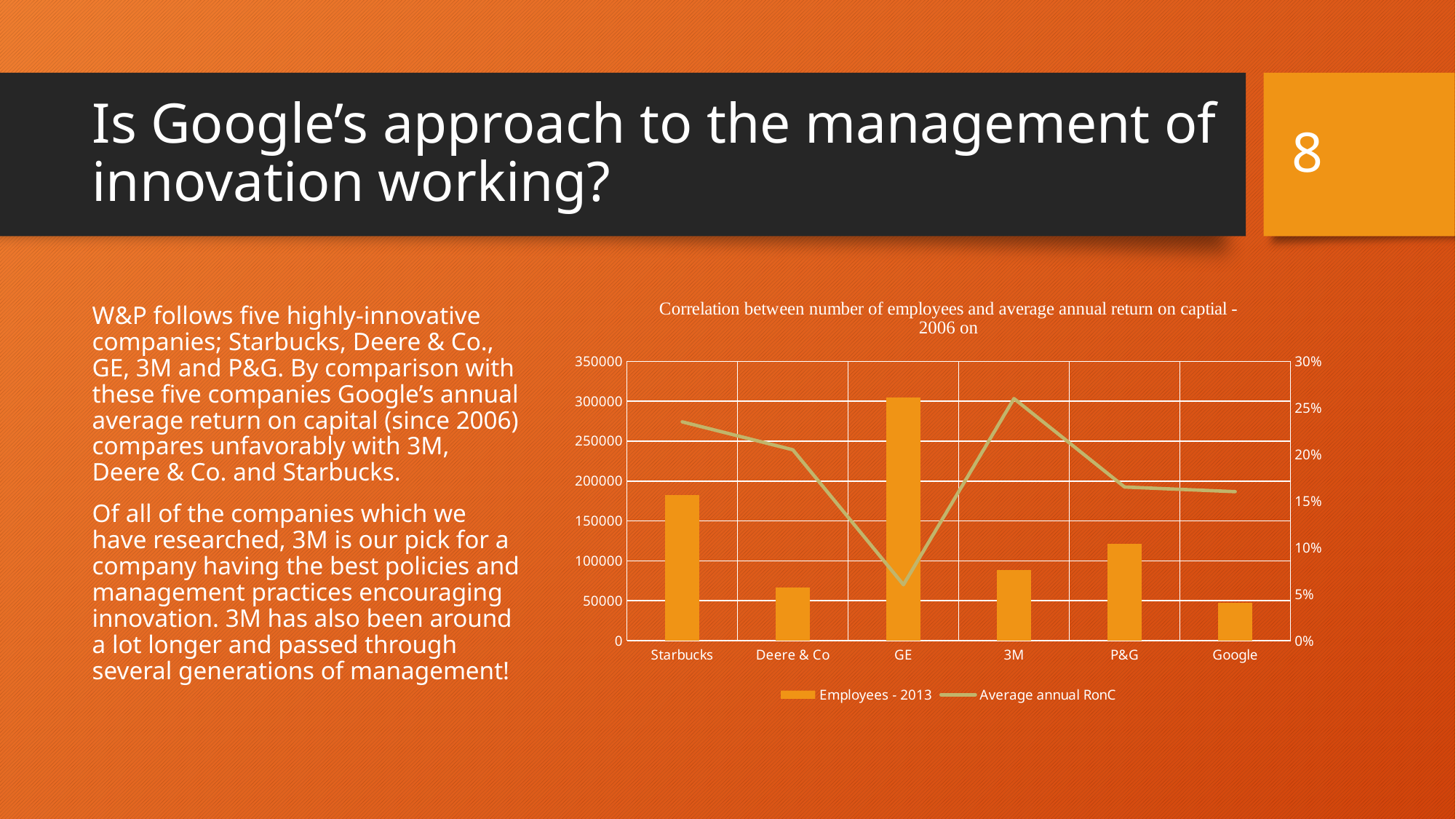
Is the Employees - 2013 value for Starbucks greater or less than 150000? greater Which company has the tallest Employees - 2013 bar? GE Which company has the shortest Employees - 2013 bar? Google Is the Employees - 2013 value for GE greater or less than 250000? greater How many series does the chart legend list? 2 Which has the larger Employees - 2013 bar, Starbucks or P&G? Starbucks Is the Employees - 2013 value for Deere & Co greater or less than 100000? less Which company has the highest Average annual RonC on the line? 3M Which company has the lowest Average annual RonC on the line? GE What kind of chart is shown on the slide? A combination bar and line chart How many companies are shown on the x axis of the chart? 6